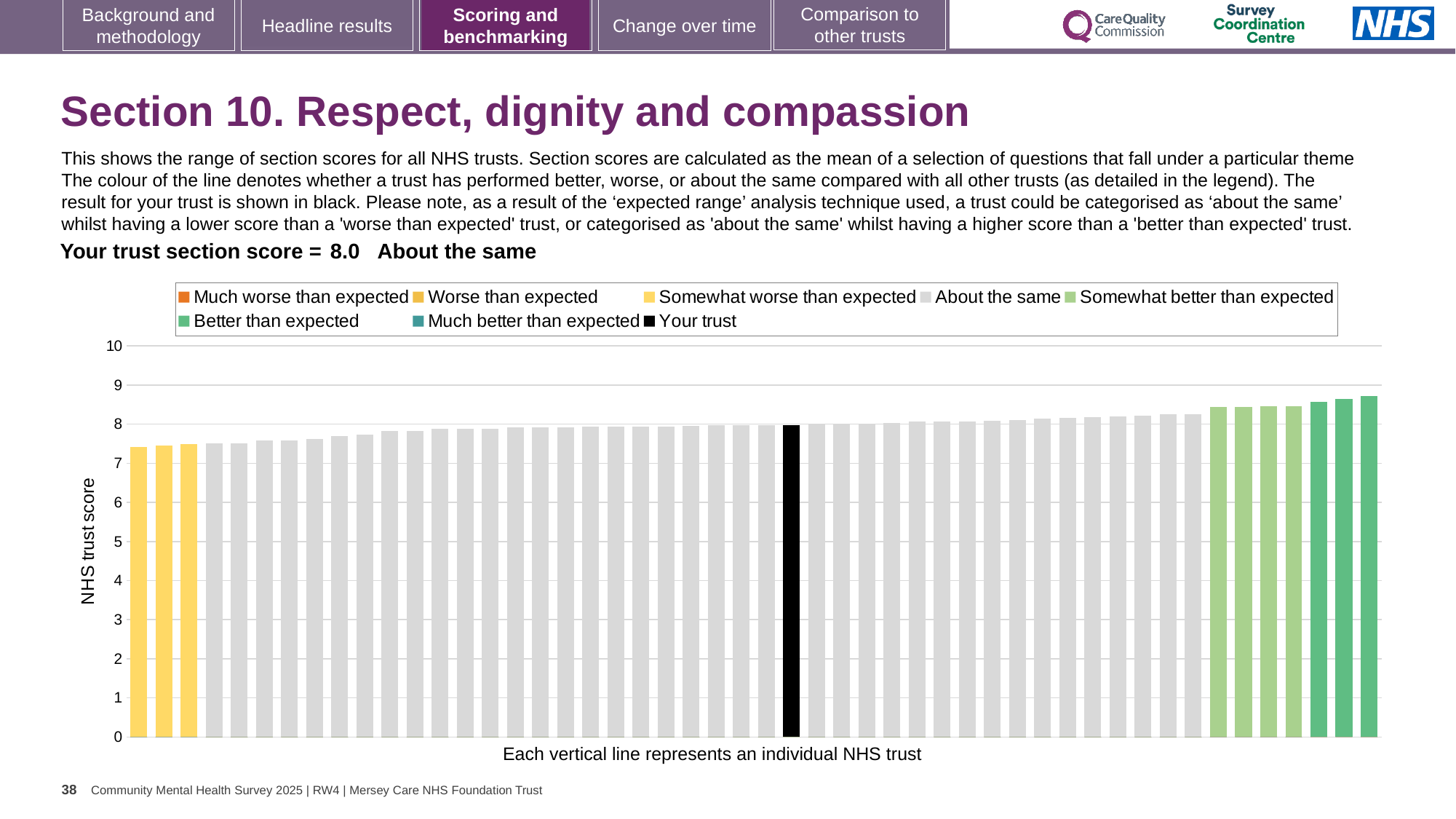
What colour is the bar representing your trust? black What is the section score for your trust shown on the slide? 8.0 Is the value of the tallest bar greater or less than 9? less Is the value of the shortest bar greater or less than 7? greater Is the value of the black 'Your trust' bar greater or less than 7? greater What kind of chart is shown on the slide? bar chart Do the bar values rise or fall from left to right along the x axis? rise How many yellow 'Somewhat worse than expected' bars are shown at the left of the chart? 3 What is the title of the vertical axis? NHS trust score How many entries does the chart legend list? 8 Which category is your trust placed in for this section? About the same